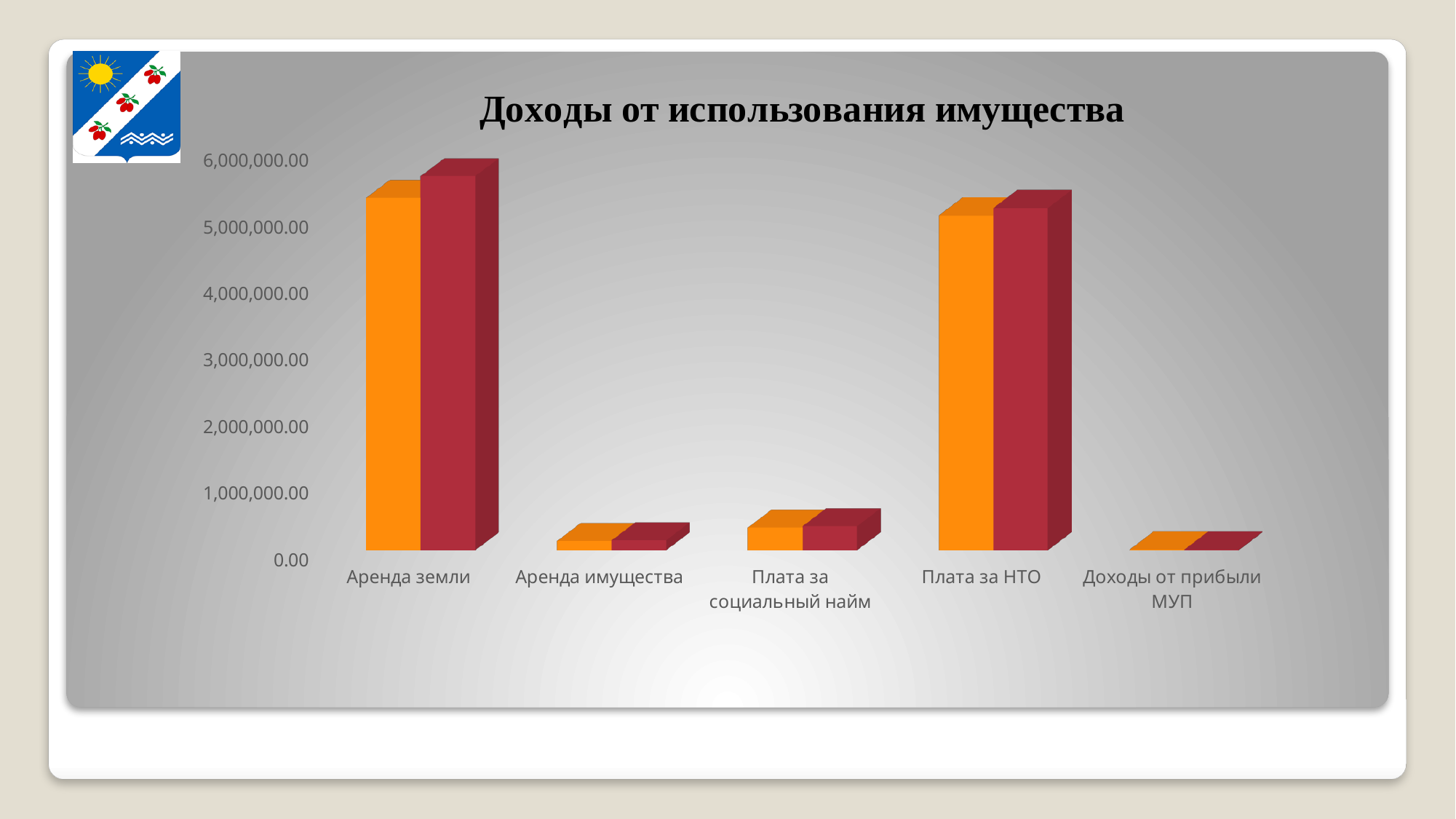
What kind of chart is shown on the slide? Bar chart How many categories are shown on the x axis of the chart? 5 Is the orange bar for Аренда имущества greater or less than 1,000,000.00? less How many bars are plotted for each category in the chart? 2 Is the red bar for Аренда земли greater or less than 6,000,000.00? less Which is larger, the orange bar for Плата за социальный найм or the orange bar for Аренда имущества? Плата за социальный найм Is the orange bar for Аренда земли greater or less than 5,000,000.00? greater Which category has the highest bars in the chart? Аренда земли Which is larger, the orange bar for Аренда земли or the orange bar for Плата за НТО? Аренда земли What is the title of the chart? Доходы от использования имущества Which category has the lowest bars in the chart? Доходы от прибыли МУП